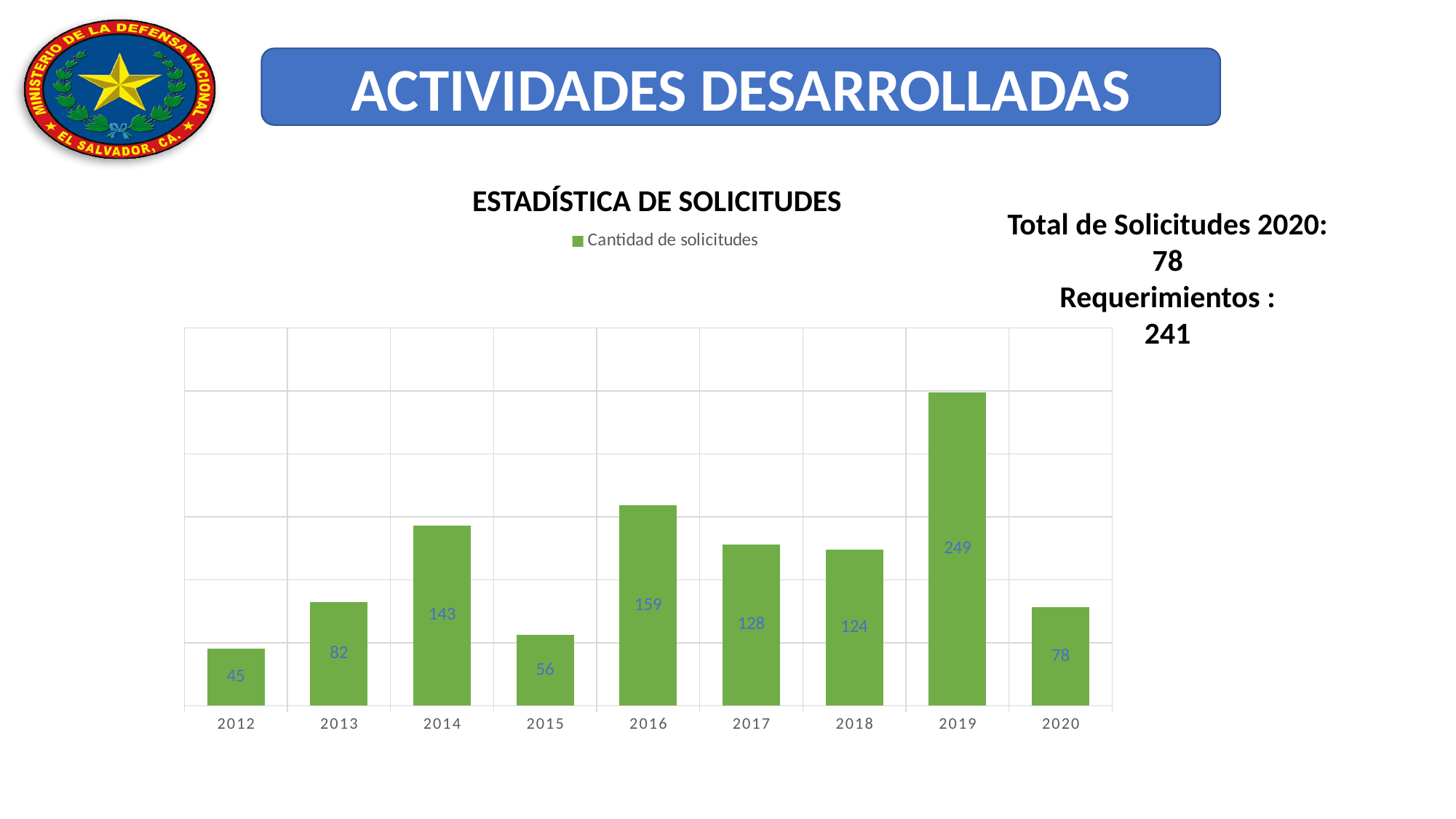
How many series does the chart legend list? 1 What kind of chart is shown on the slide? bar chart Which is larger, the value for 2017 or the value for 2018? 2017 What is the difference between the values for 2016 and 2015? 103 What is the title of the chart? ESTADÍSTICA DE SOLICITUDES What is the value for 2012 in the chart? 45 What is the difference between the values for 2019 and 2020? 171 Which year has the lowest value in the chart? 2012 What is the value for 2019 in the chart? 249 What is the value for 2014 in the chart? 143 Which year has the highest value in the chart? 2019 How many years are shown on the x axis of the chart? 9